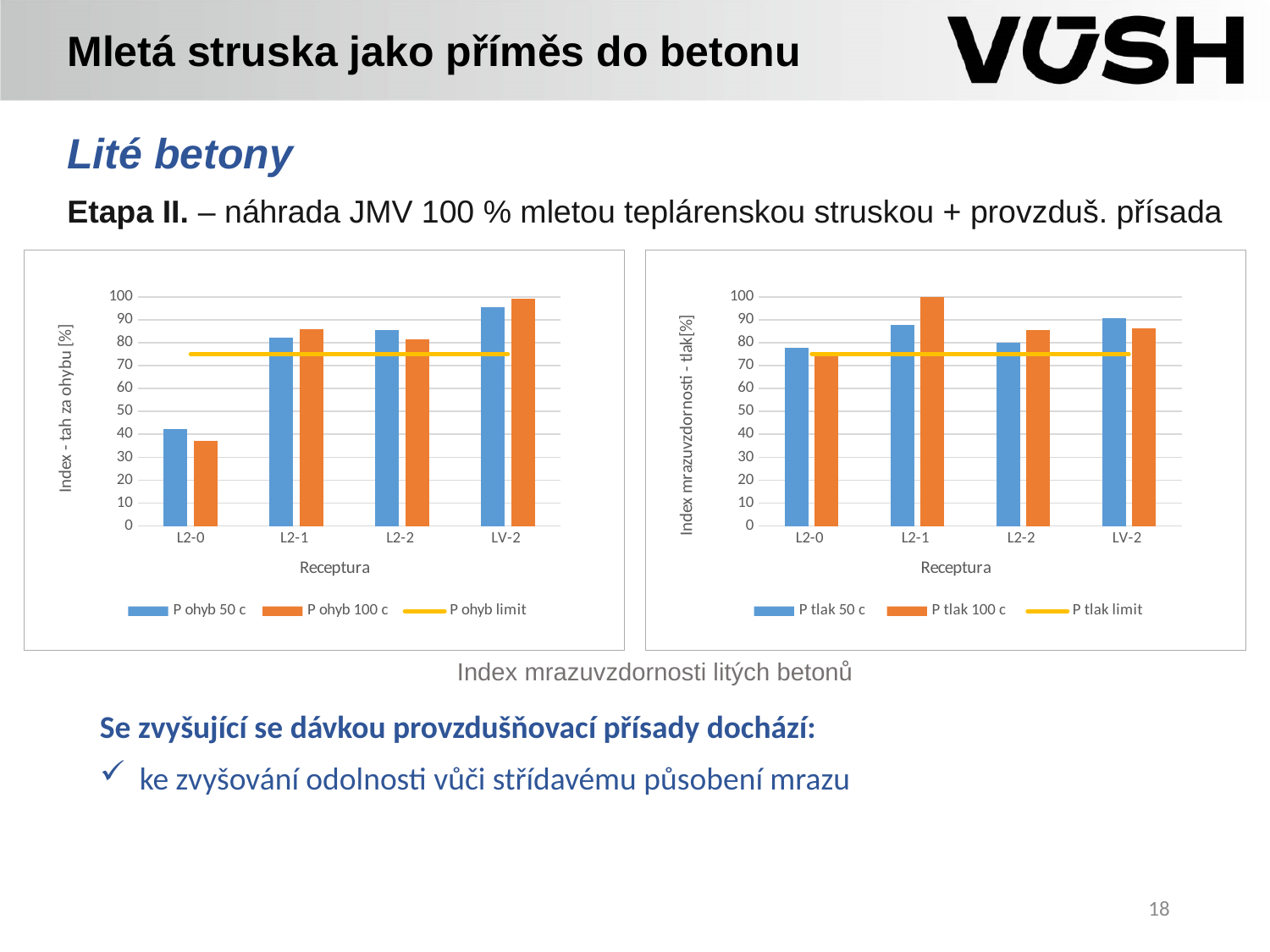
In the right chart, which category has the highest value for P tlak 100 c? L2-1 In the right chart, is the value for P tlak 50 c at L2-0 greater or less than 70? greater What is the x-axis title of the right chart? Receptura In the right chart, which category has the lowest value for P tlak 100 c? L2-0 In the right chart, at L2-1, which is larger: P tlak 50 c or P tlak 100 c? P tlak 100 c In the left chart, which category has the highest value for P ohyb 100 c? LV-2 In the right chart, how many entries does the legend list? 3 What kind of chart is the left chart? combination bar and line chart In the left chart, is the value for P ohyb 100 c at L2-0 greater or less than 40? less In the left chart, how many categories are shown on the x axis? 4 In the left chart, is the value for P ohyb 100 c at LV-2 greater or less than 90? greater In the left chart, which category has the lowest value for P ohyb 50 c? L2-0